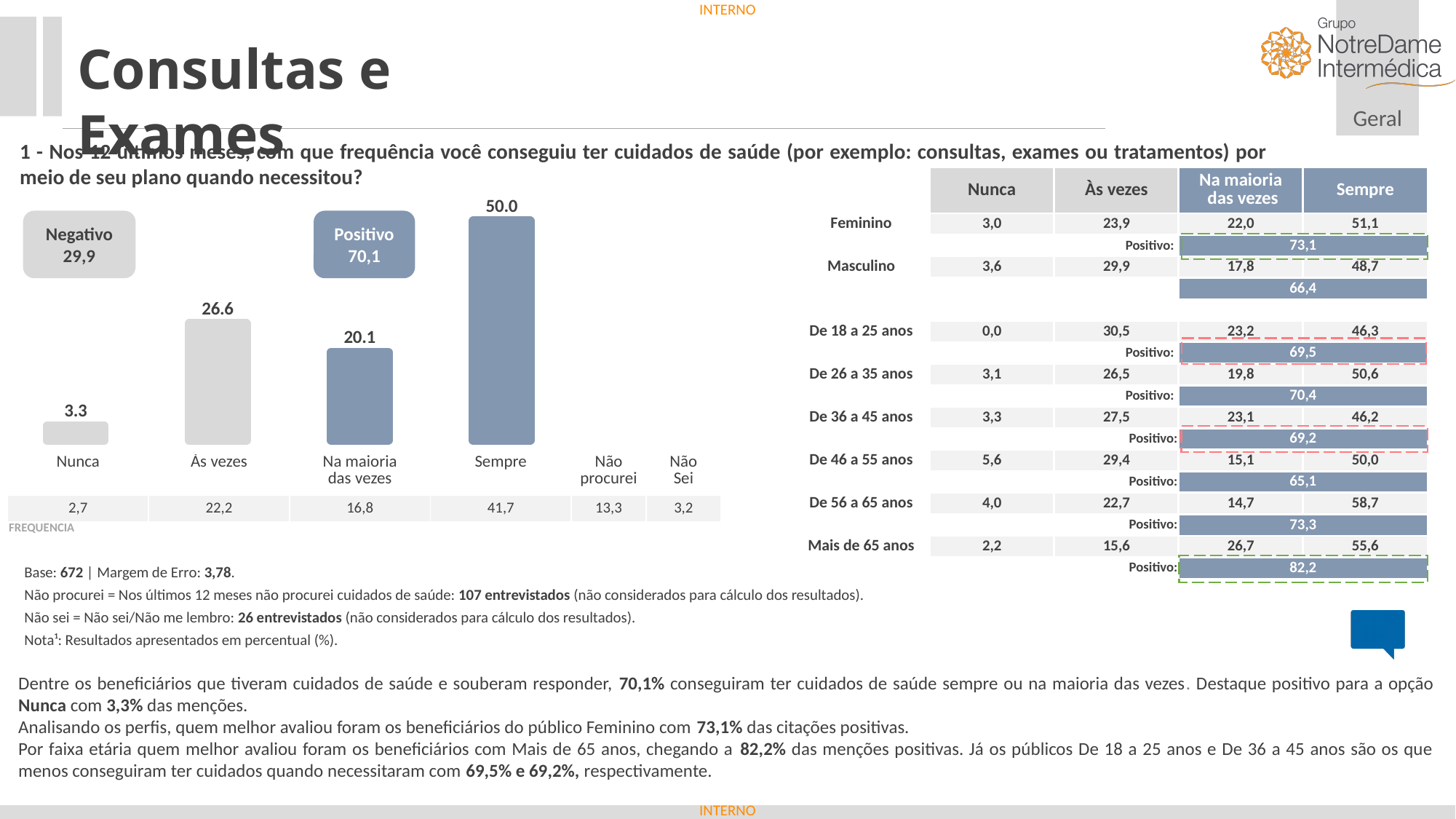
What is the difference between the values for Sempre and Às vezes? 23.4 What is the value of the bar for Na maioria das vezes? 20.1 What value is shown in the Positivo box above the chart? 70,1 What is the value of the bar for Às vezes? 26.6 What type of chart is shown on the slide? Bar chart Which category has the highest bar in the chart? Sempre What value is shown in the Negativo box above the chart? 29,9 What is the value of the bar for Sempre? 50.0 Which is larger, the bar for Às vezes or the bar for Na maioria das vezes? Às vezes Which category has the lowest bar in the chart? Nunca What is the value of the bar for Nunca? 3.3 What is the difference between the values for Às vezes and Na maioria das vezes? 6.5